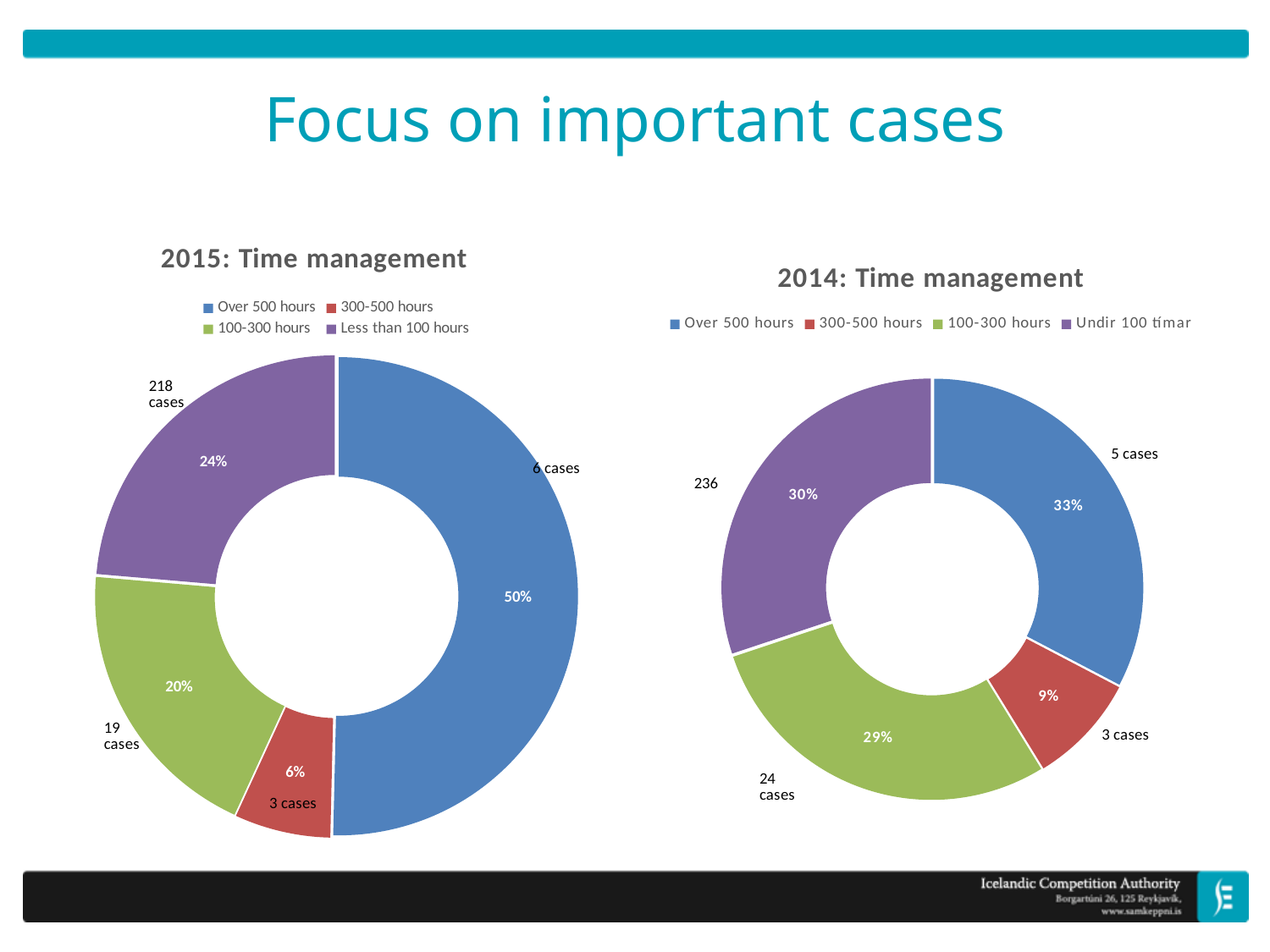
In the '2015: Time management' chart, what is the difference in percentage points between the 'Less than 100 hours' slice and the '100-300 hours' slice? 4% In the '2014: Time management' chart, which category has the largest percentage? Over 500 hours In the '2015: Time management' chart, what percentage is shown for the 'Over 500 hours' slice? 50% How many entries does the legend of the '2015: Time management' chart list? 4 What type of chart is the '2015: Time management' chart? Doughnut chart In the '2014: Time management' chart, what percentage is shown for the '300-500 hours' slice? 9% In the '2014: Time management' chart, what colour is the 'Over 500 hours' slice? Blue In the '2015: Time management' chart, which category has the smallest percentage? 300-500 hours In the '2014: Time management' chart, which is larger, the percentage for 'Undir 100 tímar' or for '100-300 hours'? Undir 100 tímar How many slices does the '2014: Time management' chart have? 4 In the '2014: Time management' chart, how many cases are labelled for the '100-300 hours' slice? 24 cases In the '2015: Time management' chart, how many cases are labelled for the 'Less than 100 hours' slice? 218 cases